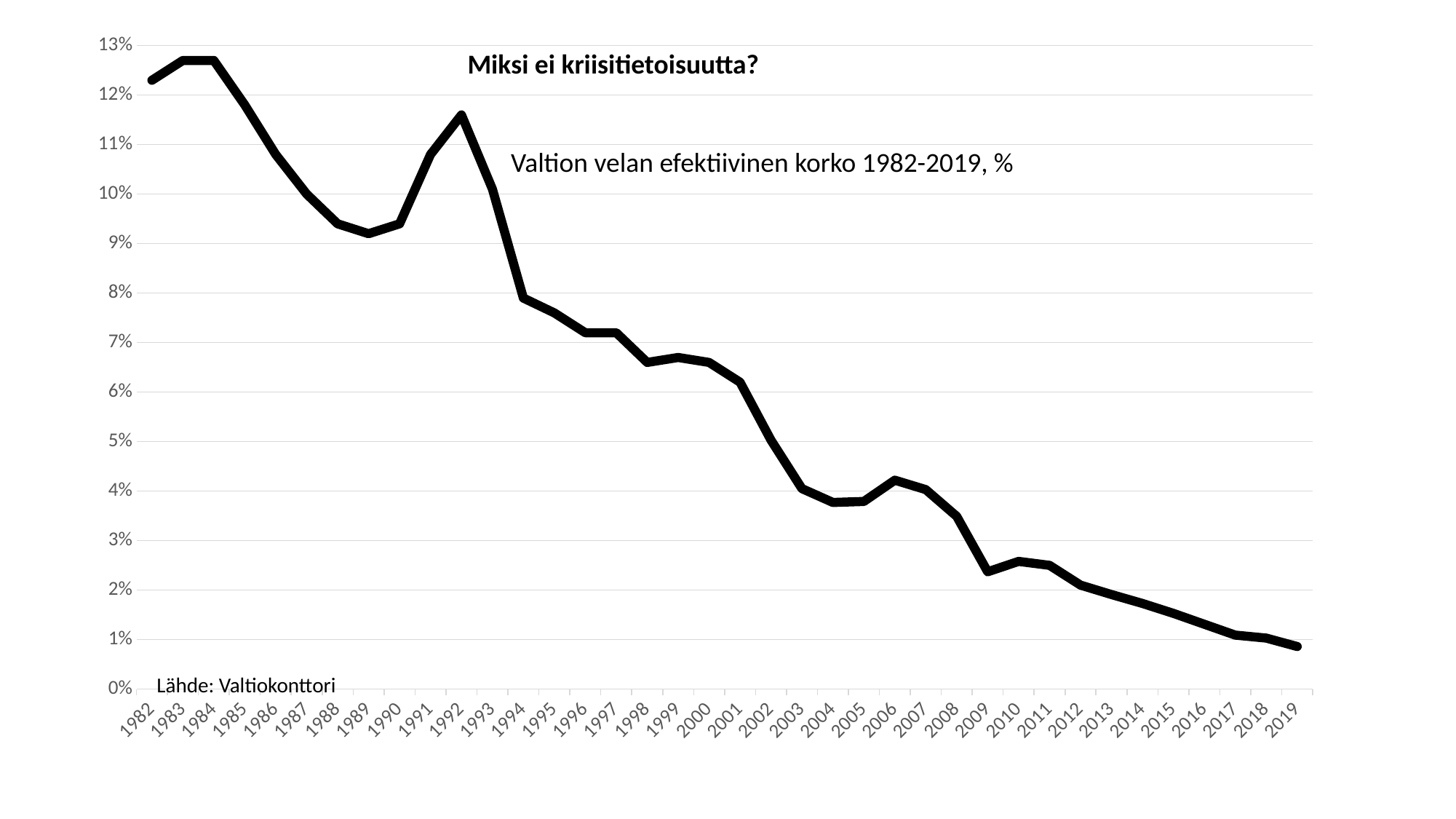
Is the value for 1989 greater or less than 10%? less Is the value for 2015 greater or less than 2%? less Do the values generally rise or fall from 1982 to 2019? fall Which year has the lowest value? 2019 What kind of chart is shown on the slide? line chart Is the value for 1992 greater or less than 11%? greater What is the title of the chart? Valtion velan efektiivinen korko 1982-2019, % Which is larger, the value for 1990 or the value for 1991? 1991 Which is larger, the value for 1992 or the value for 1993? 1992 How many years are plotted on the x axis? 38 What source is cited for the chart? Valtiokonttori